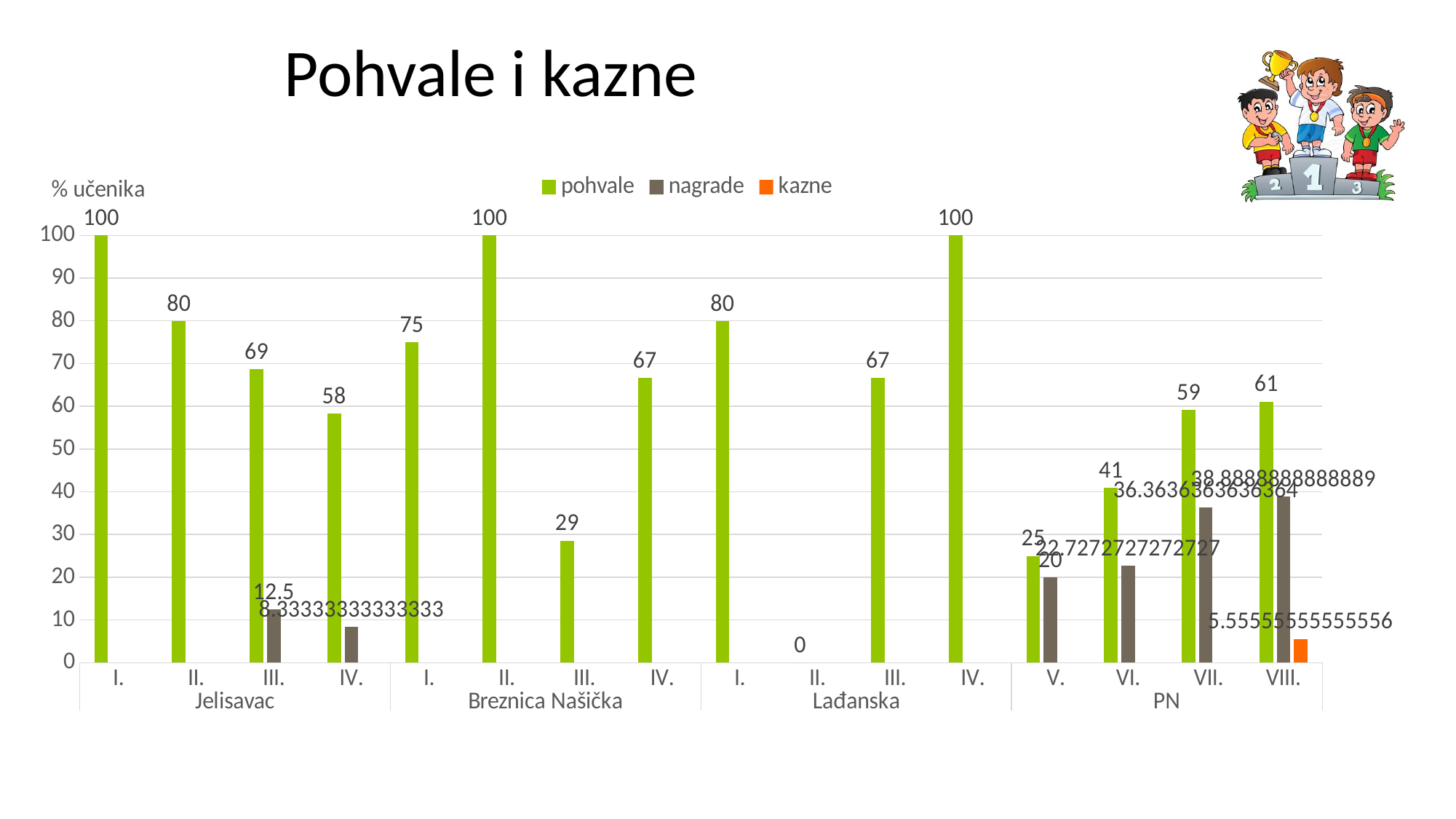
What is the nagrade value for class III. in Jelisavac? 12.5 Which is larger, the pohvale value for class I. in Breznica Našička or for class I. in Lađanska? class I. in Lađanska What is the pohvale value for class III. in Breznica Našička? 29 Which class in PN has the highest pohvale value? VIII. What is the nagrade value for class V. in PN? 20 What is the pohvale value for class II. in Lađanska? 0 What is the difference between the pohvale values for class I. and class IV. in Jelisavac? 42 What is the pohvale value for class III. in Jelisavac? 69 What type of chart is shown on the slide? bar chart Which series is shown in orange in the legend? kazne How many series does the legend list? 3 Which class in Jelisavac has the lowest pohvale value? IV.